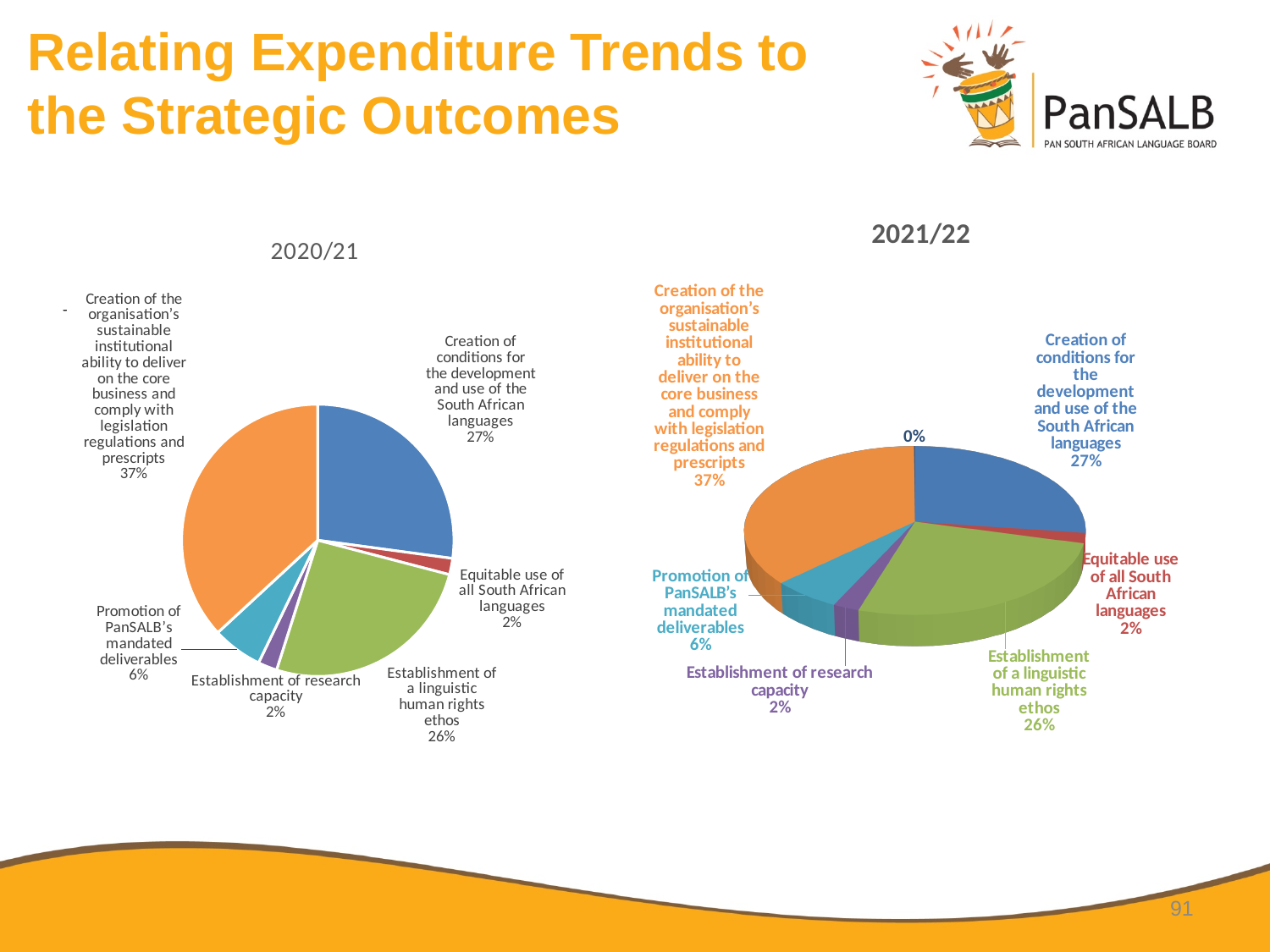
In the 2021/22 pie chart, which is larger: Promotion of PanSALB's mandated deliverables or Establishment of research capacity? Promotion of PanSALB's mandated deliverables What kind of chart is used for 2020/21? Pie chart In the 2020/21 pie chart, which category has the largest share? Creation of the organisation's sustainable institutional ability to deliver on the core business and comply with legislation regulations and prescripts In the 2020/21 pie chart, what share is shown for Promotion of PanSALB's mandated deliverables? 6% In the 2020/21 pie chart, what share of expenditure goes to Creation of conditions for the development and use of the South African languages? 27% What is the title of the pie chart on the right of the slide? 2021/22 In the 2020/21 pie chart, what is the combined share of Equitable use of all South African languages and Establishment of research capacity? 4% In the 2021/22 pie chart, what share is shown for Establishment of a linguistic human rights ethos? 26% How many labelled categories with a percentage are shown in the 2020/21 pie chart? 6 In the 2021/22 pie chart, what is the share of the largest slice? 37% In the 2021/22 pie chart, what share is shown for Equitable use of all South African languages? 2% In the 2020/21 pie chart, what is the difference in percentage points between Creation of conditions for the development and use of the South African languages and Establishment of a linguistic human rights ethos? 1